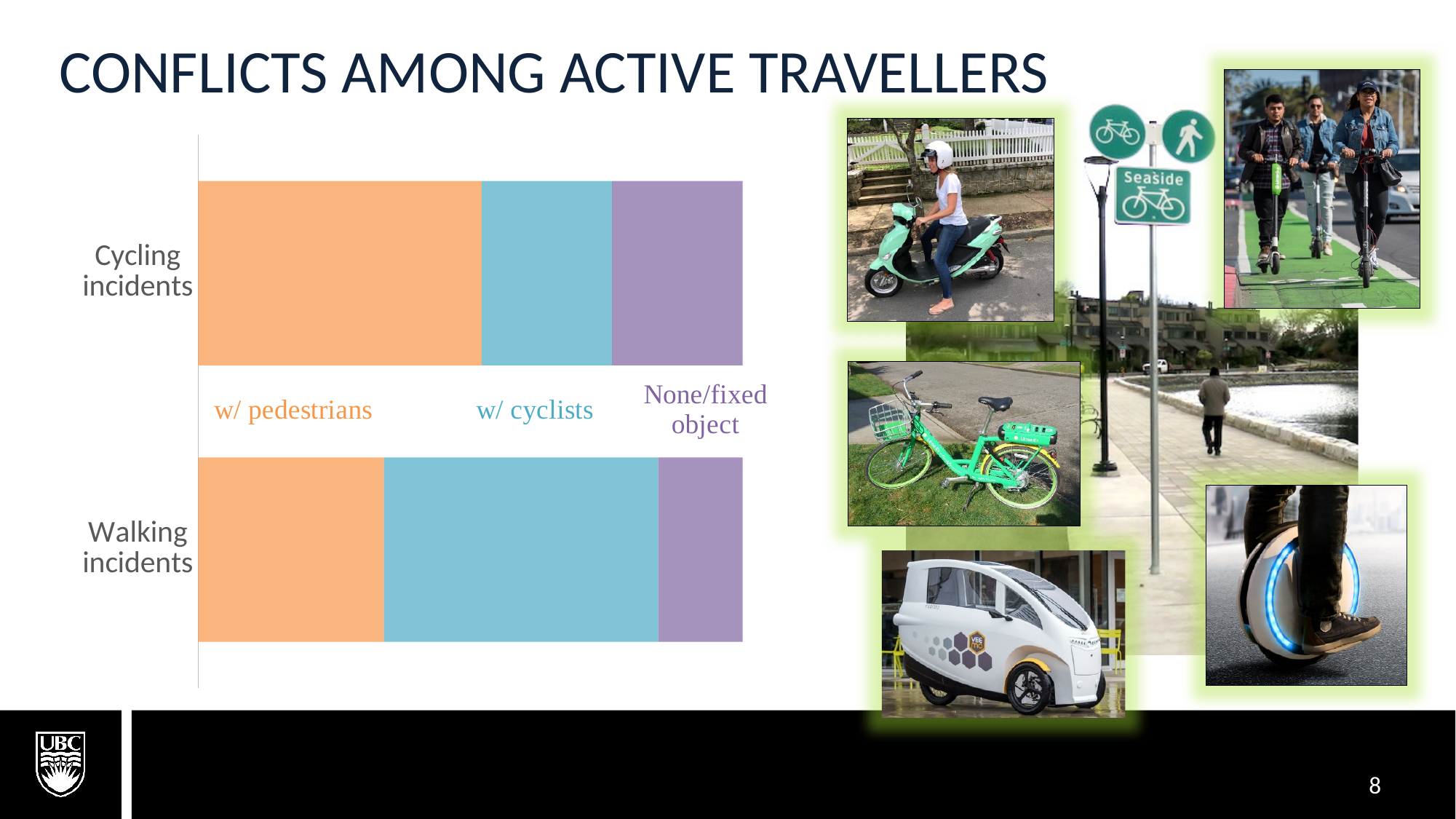
Is the None/fixed object segment larger for Cycling incidents or for Walking incidents? Cycling incidents How many series does the chart's legend list? 3 How many categories (bars) does the chart show? 2 Which series takes up the largest share of the Walking incidents bar? w/ cyclists Is the w/ cyclists segment larger for Cycling incidents or for Walking incidents? Walking incidents What kind of chart is shown on the slide? Stacked bar chart Which series takes up the smallest share of the Walking incidents bar? None/fixed object What is the title of the slide containing the chart? CONFLICTS AMONG ACTIVE TRAVELLERS Is the w/ pedestrians segment larger for Cycling incidents or for Walking incidents? Cycling incidents Which series takes up the largest share of the Cycling incidents bar? w/ pedestrians What colour represents the w/ cyclists series in the chart? Blue